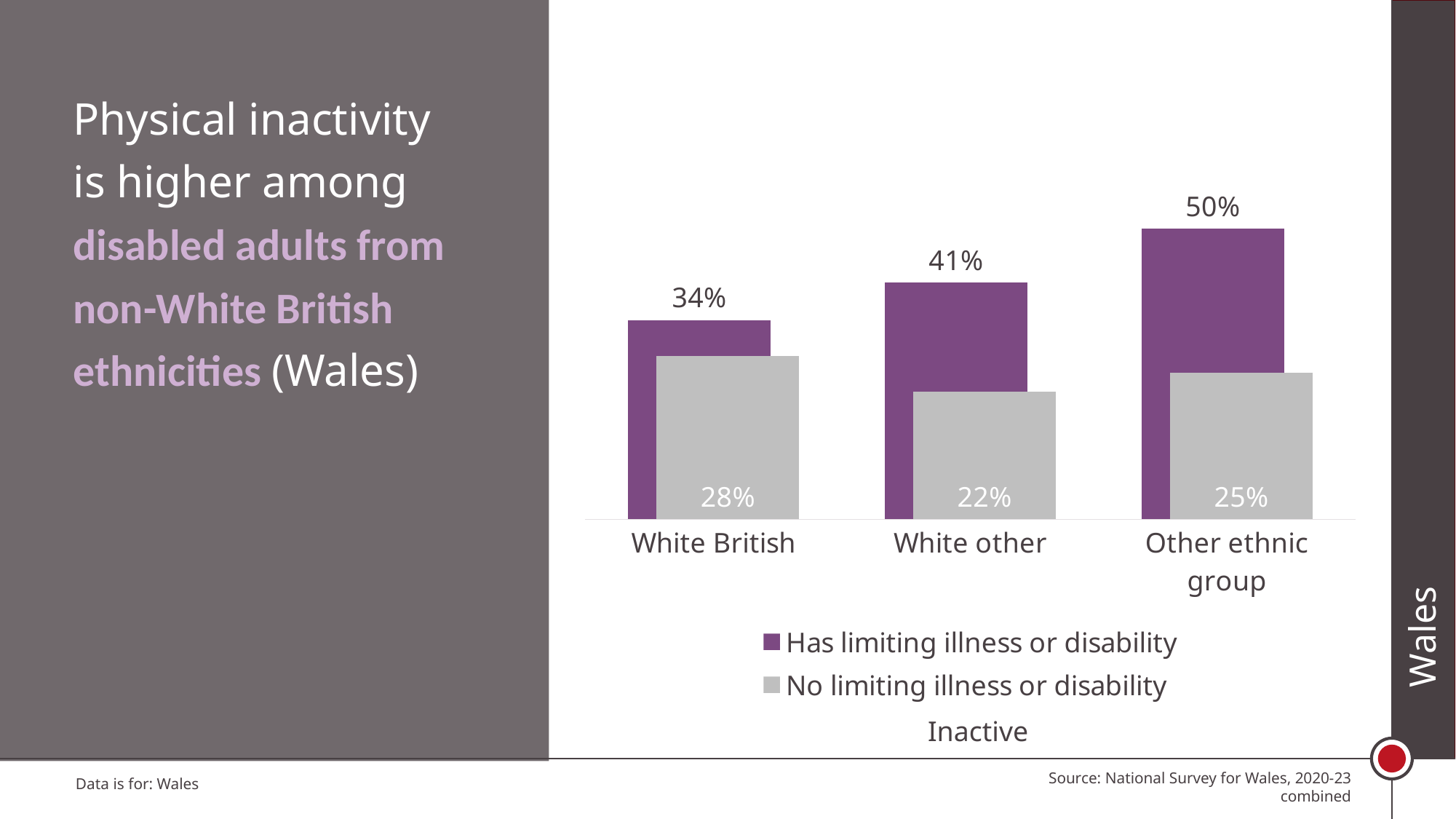
How many series does the legend list? 2 How many ethnic group categories are shown on the x axis? 3 What is the value for White British adults who have a limiting illness or disability? 34% What is the difference between the 'Has limiting illness or disability' and 'No limiting illness or disability' values for the Other ethnic group? 25% What is the value for the Other ethnic group with a limiting illness or disability? 50% What is the difference between the 'Has limiting illness or disability' values for White other and White British? 7% Which ethnic group has the lowest inactivity rate among those with no limiting illness or disability? White other Which is larger: the 'No limiting illness or disability' value for White British or for Other ethnic group? White British Which colour represents 'Has limiting illness or disability' in the legend? Purple What is the value for White other adults with no limiting illness or disability? 22% What kind of chart is shown on the slide? Bar chart Which ethnic group has the highest inactivity rate among those with a limiting illness or disability? Other ethnic group